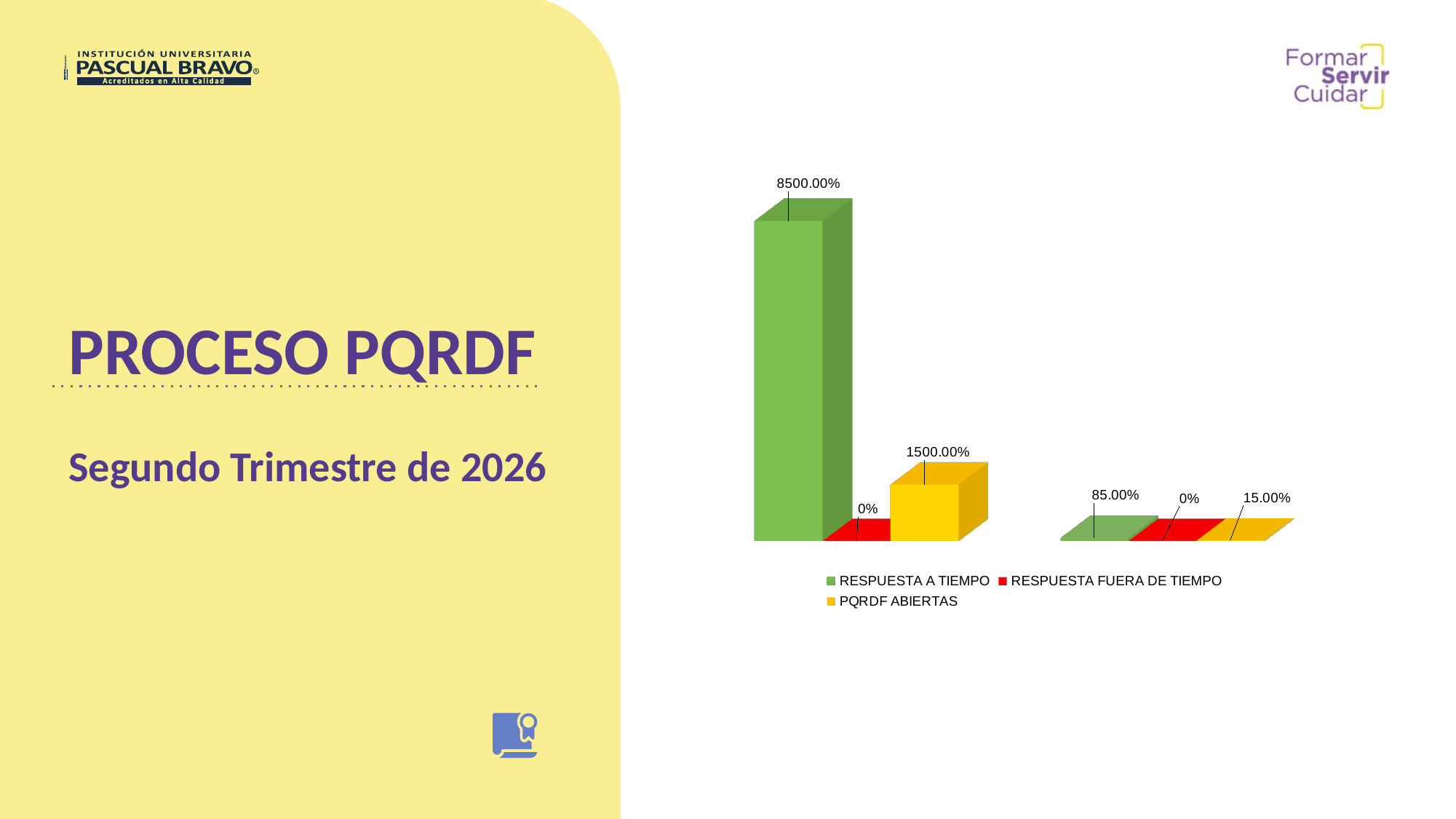
What is the difference between RESPUESTA A TIEMPO and PQRDF ABIERTAS in the right group of bars? 70.00% Which series has the lowest value in the right group of bars? RESPUESTA FUERA DE TIEMPO What is the value of PQRDF ABIERTAS in the right group of bars? 15.00% Which series has the highest value in the left group of bars? RESPUESTA A TIEMPO What is the value of RESPUESTA A TIEMPO in the right group of bars? 85.00% What is the value of RESPUESTA A TIEMPO in the left group of bars? 8500.00% How many series does the chart legend list? 3 What kind of chart is shown on the slide? bar chart What is the value of PQRDF ABIERTAS in the left group of bars? 1500.00% What is the value of RESPUESTA FUERA DE TIEMPO in the left group of bars? 0% What colour represents PQRDF ABIERTAS in the chart? yellow In the left group of bars, which is larger: RESPUESTA A TIEMPO or PQRDF ABIERTAS? RESPUESTA A TIEMPO